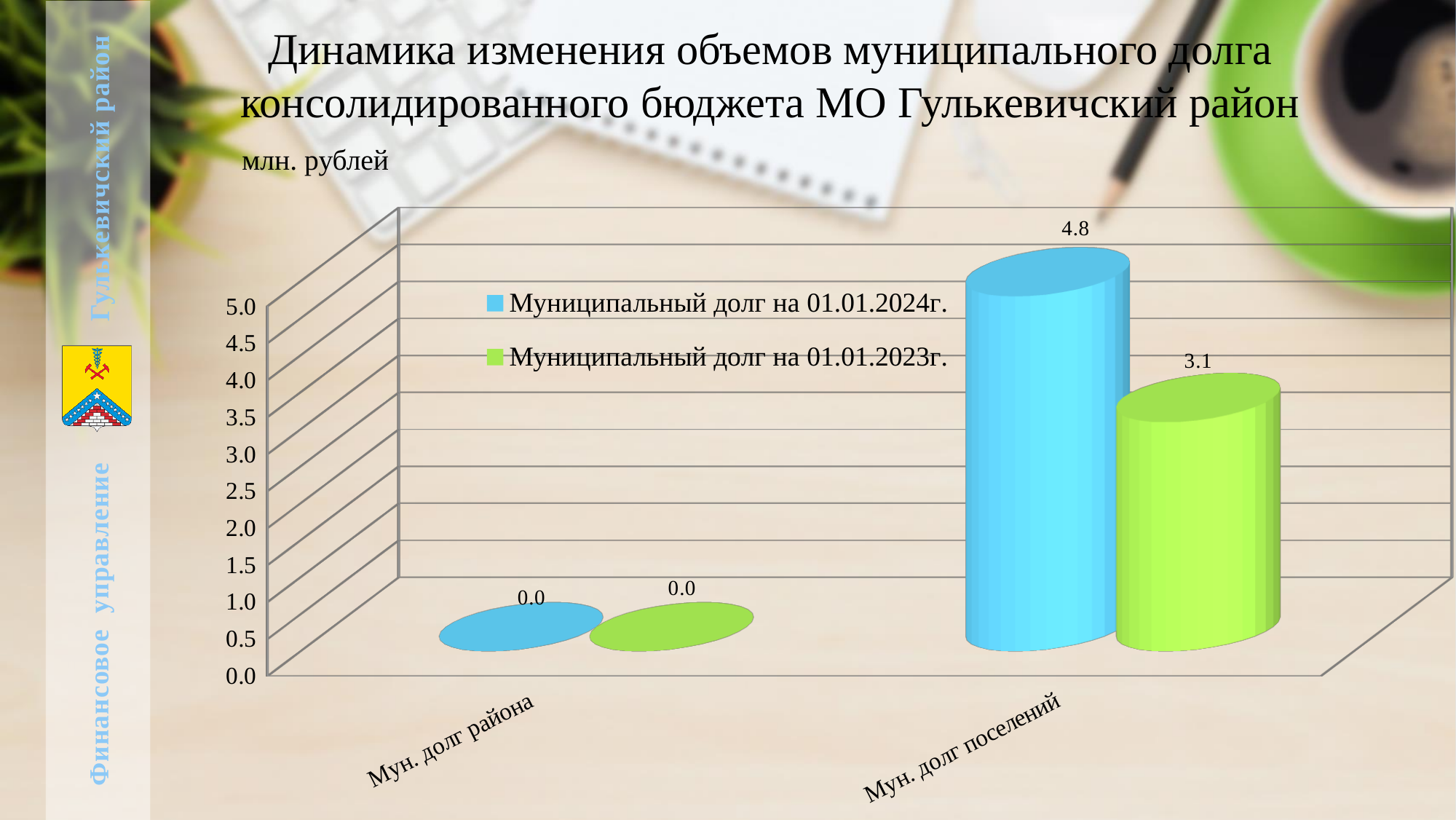
What is the value of 'Муниципальный долг на 01.01.2023г.' for 'Мун. долг района'? 0.0 How many categories are shown on the x axis of the chart? 2 What unit of measurement is stated for the chart values? млн. рублей What is the value of 'Муниципальный долг на 01.01.2024г.' for 'Мун. долг поселений'? 4.8 What is the value of 'Муниципальный долг на 01.01.2023г.' for 'Мун. долг поселений'? 3.1 What is the value of 'Муниципальный долг на 01.01.2024г.' for 'Мун. долг района'? 0.0 For 'Мун. долг поселений', which is larger: the value on 01.01.2024 or on 01.01.2023? 01.01.2024 Which category has the highest value for 'Муниципальный долг на 01.01.2024г.'? Мун. долг поселений What kind of chart is shown on the slide? bar chart What is the difference between the 01.01.2024 and 01.01.2023 values for 'Мун. долг поселений'? 1.7 How many series does the chart legend list? 2 Is the value of 'Муниципальный долг на 01.01.2023г.' for 'Мун. долг поселений' greater or less than 4.0? less